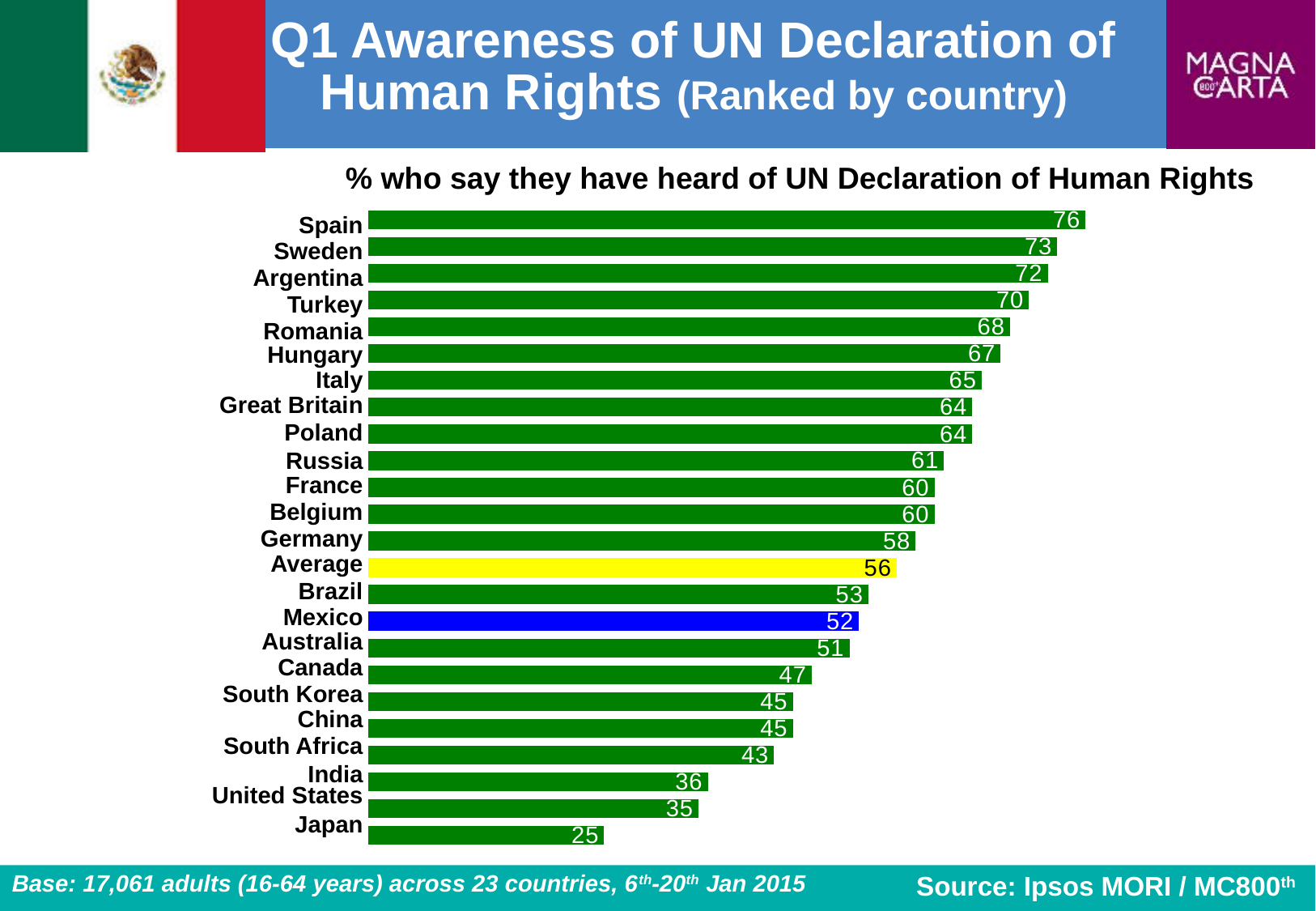
What kind of chart is shown on the slide? Bar chart How many bars are shown in the chart, including the Average? 24 What is the difference between the values for Spain and Japan? 51 What is the value for Spain? 76 What is the value for Mexico? 52 Which country has the highest value? Spain Which bar is coloured blue? Mexico Which country has the lowest value? Japan What is the value shown for Average? 56 Which has a larger value, Brazil or Canada? Brazil What is the difference between the values for Mexico and the Average? 4 What is the value for Japan? 25